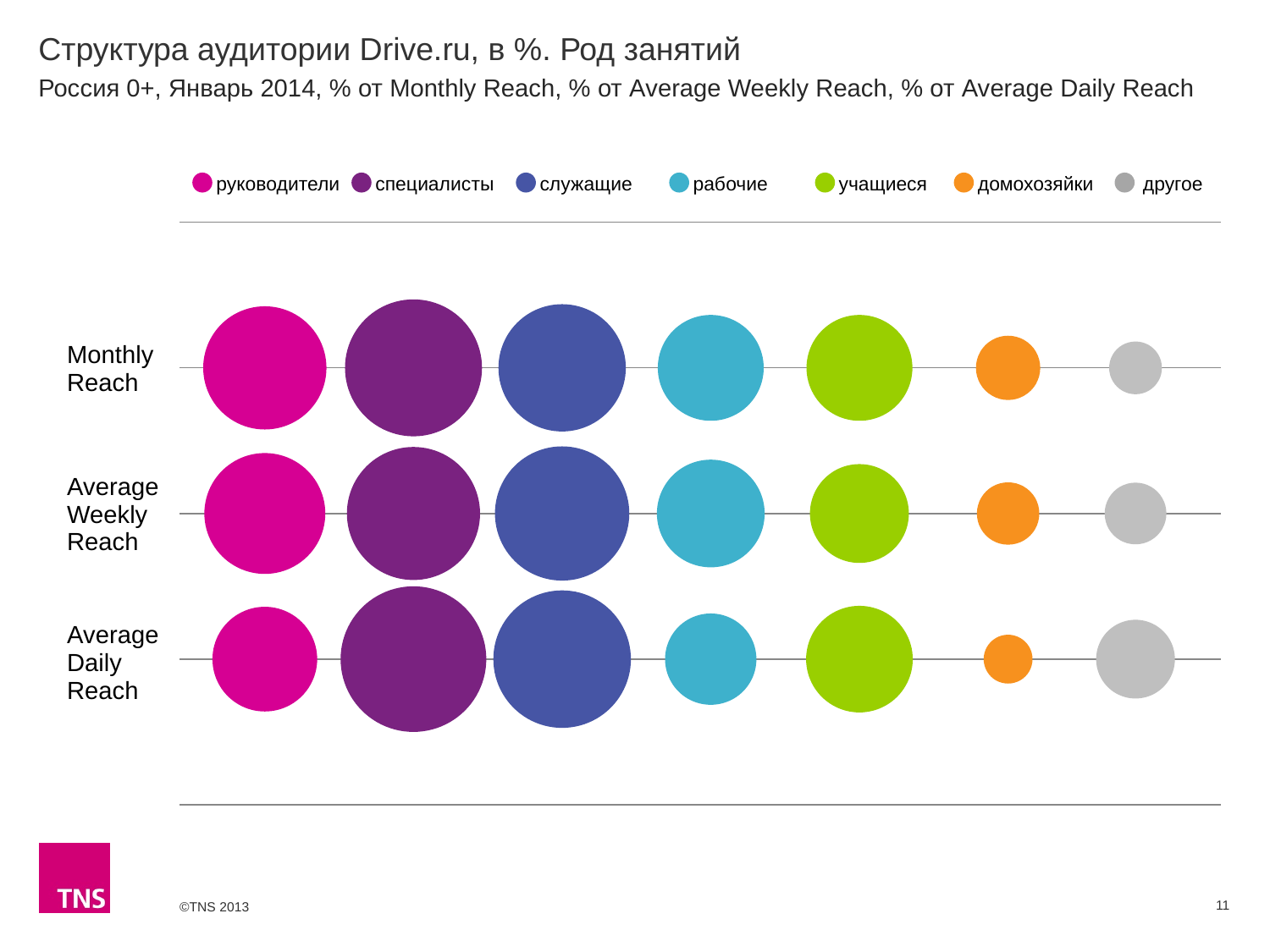
Which occupation group is shown in orange in the legend? домохозяйки Does the bubble for другое get larger or smaller going from Monthly Reach to Average Daily Reach? larger What is the title of the chart on the slide? Структура аудитории Drive.ru, в %. Род занятий How many reach categories (rows) are plotted on the chart? 3 What kind of chart is shown on the slide? Bubble chart Which occupation group has the largest bubble in the Monthly Reach row? специалисты Which occupation group has the largest bubble in the Average Daily Reach row? специалисты Which occupation group has the smallest bubble in the Average Daily Reach row? домохозяйки In the Monthly Reach row, which bubble is larger: руководители or рабочие? руководители How many series does the legend list? 7 In the Average Daily Reach row, which bubble is larger: другое or домохозяйки? другое In the Average Weekly Reach row, which bubble is larger: учащиеся or домохозяйки? учащиеся